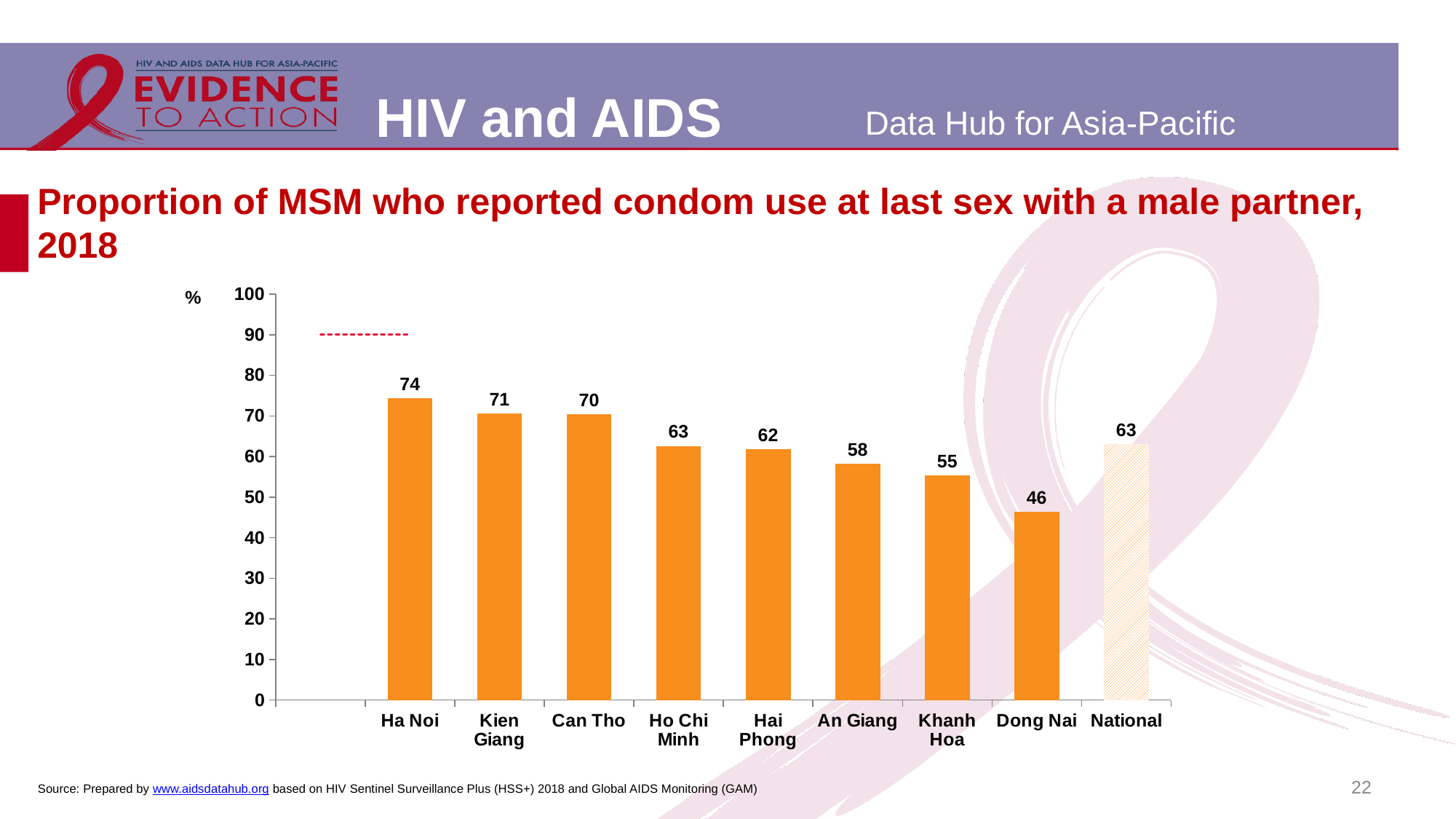
How many categories are shown on the x axis? 9 What is the value for Ha Noi? 74 Which category has the highest value? Ha Noi Do the values rise or fall from Ha Noi to Dong Nai along the x axis? fall Is the value for An Giang greater or less than 50? greater What is the value for Dong Nai? 46 What is the difference between the values for Ho Chi Minh and Hai Phong? 1 Which is larger, the value for Kien Giang or the value for Khanh Hoa? Kien Giang What is the National value? 63 What is the difference between the values for Ha Noi and Dong Nai? 28 Which category has the lowest value? Dong Nai What kind of chart is shown on the slide? bar chart